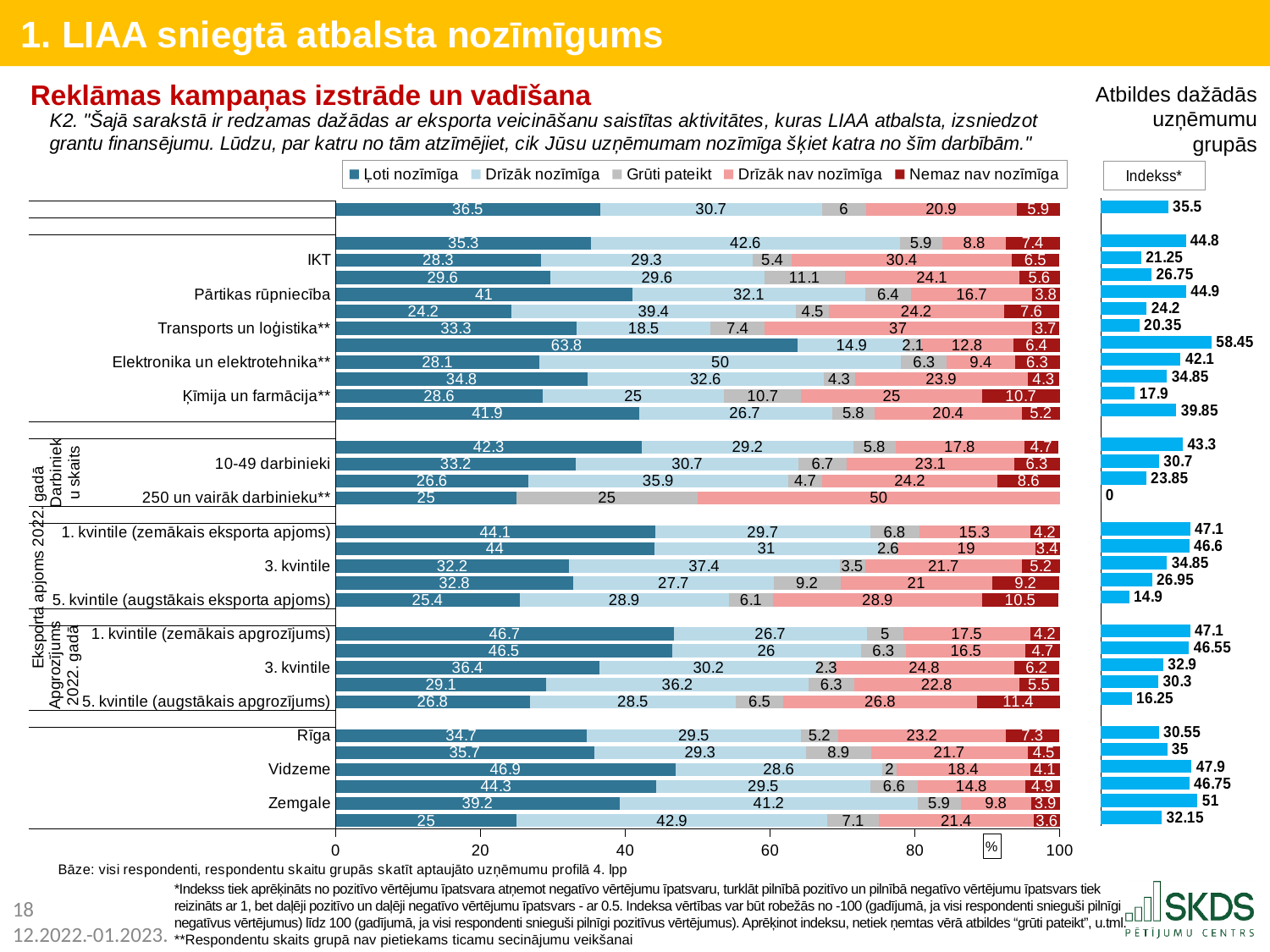
In the main chart, what is the "Drīzāk nav nozīmīga" value for Transports un loģistika**? 37 In the main chart, what is the "Drīzāk nozīmīga" value for Elektronika un elektrotehnika**? 50 In the Indekss* chart, what is the index value for Zemgale? 51 In the Indekss* chart, which has the higher index, Vidzeme or Zemgale? Zemgale In the main chart, what is the "Ļoti nozīmīga" value for Pārtikas rūpniecība? 41 How many series does the legend of the main chart list? 5 In the main chart, what is the "Nemaz nav nozīmīga" value for 5. kvintile (augstākais apgrozījums)? 11.4 In the main chart, what is the difference between the "Ļoti nozīmīga" and "Nemaz nav nozīmīga" values for Ķīmija un farmācija**? 17.9 In the main chart, what is the total of the stacked bar for Zemgale? 100 What kind of chart is the main chart on the slide? Stacked bar chart In the Indekss* chart, what is the index value for 250 un vairāk darbinieku**? 0 What is the first entry in the legend of the main chart? Ļoti nozīmīga